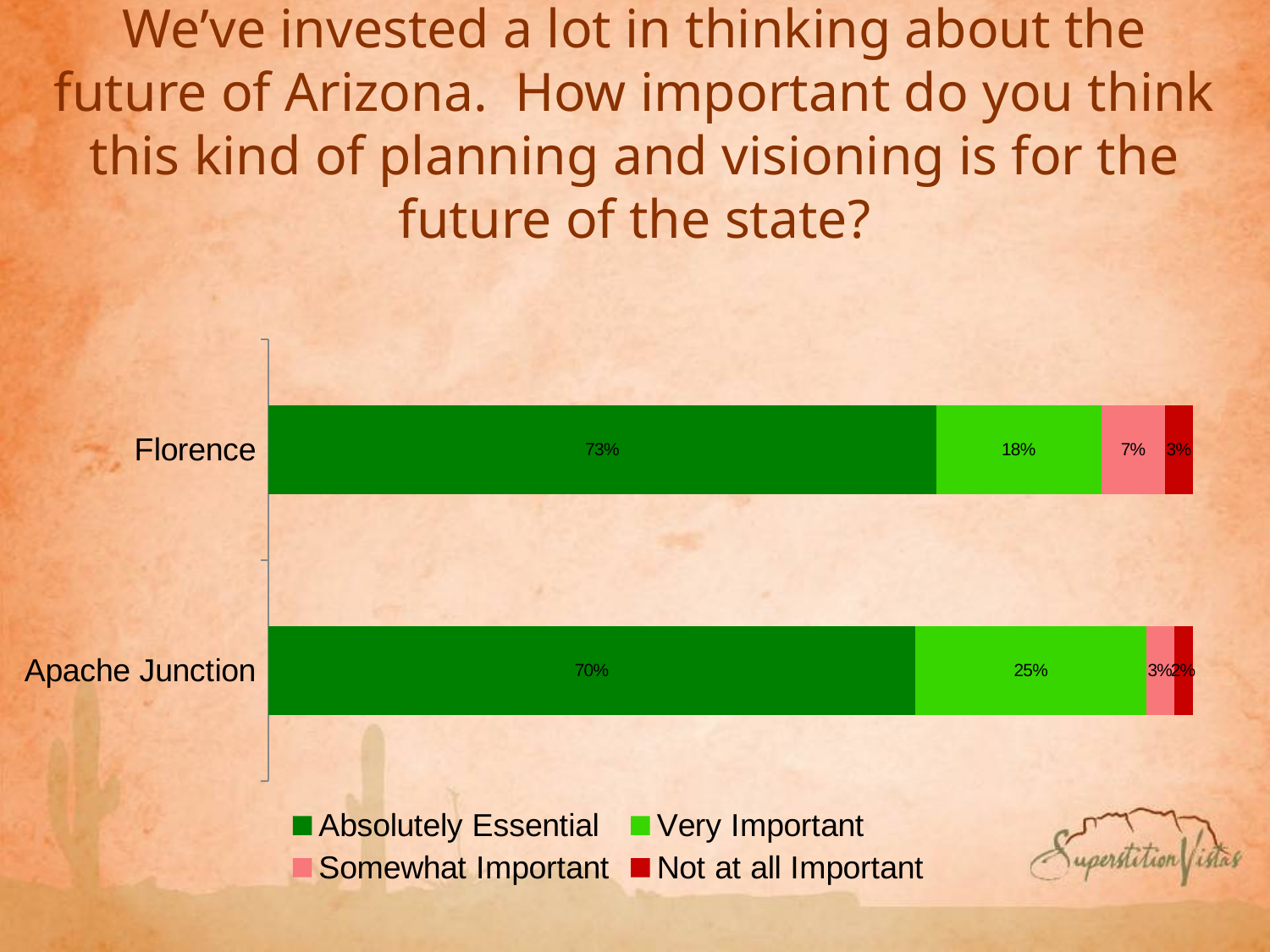
What is the difference between the Very Important values for Apache Junction and Florence? 7% What kind of chart is shown on the slide? Stacked bar chart What is the Somewhat Important value for Florence? 7% What percentage of Apache Junction respondents said planning is Very Important? 25% What is the difference between the Absolutely Essential values for Florence and Apache Junction? 3% What is the Not at all Important value for Apache Junction? 2% Which community has the higher Absolutely Essential percentage? Florence Which legend entry is shown in dark green? Absolutely Essential How many series does the legend list? 4 How many communities are shown in the chart? 2 What percentage of Florence respondents said planning is Absolutely Essential? 73% Which community has the higher Very Important percentage? Apache Junction